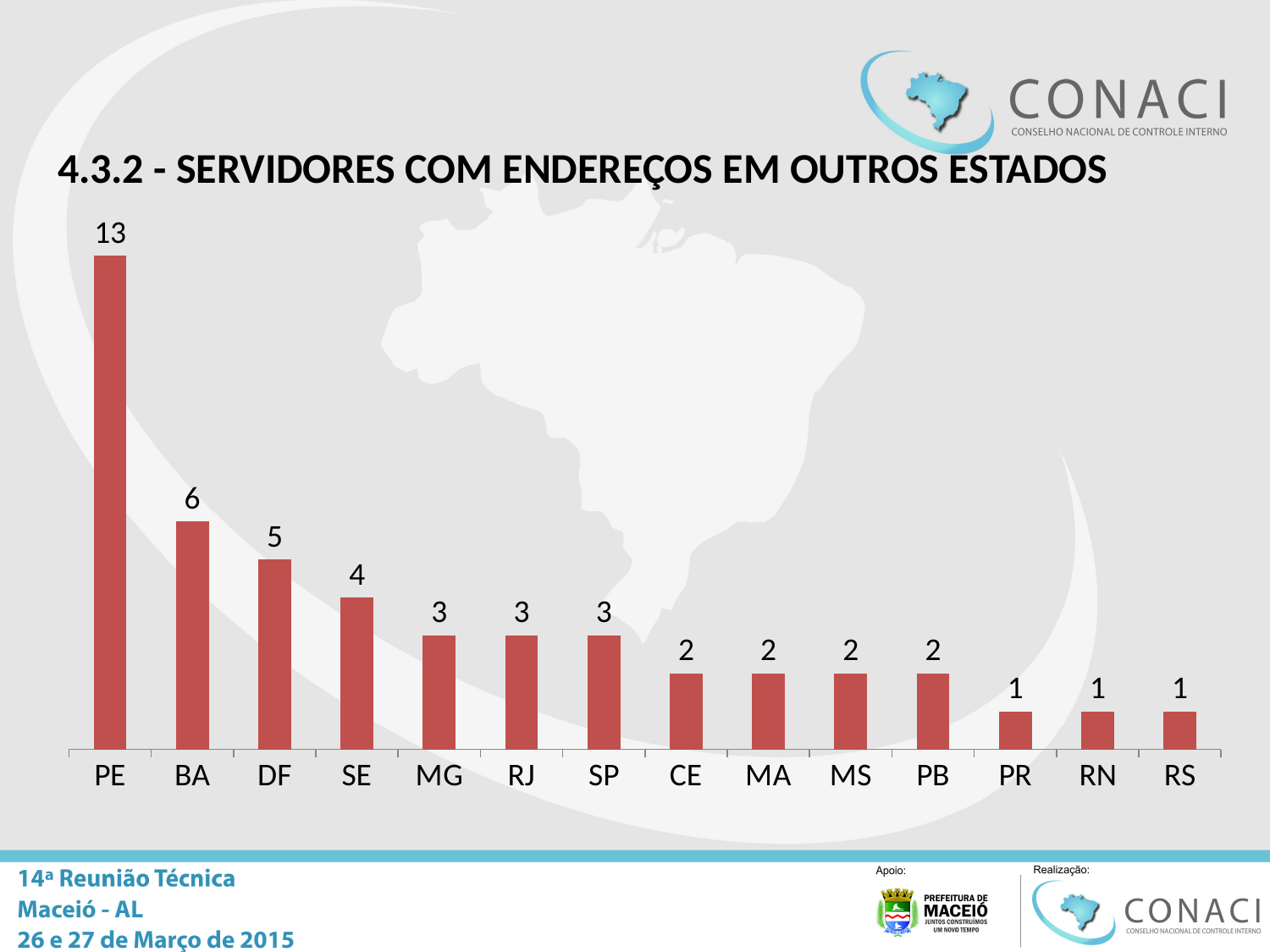
What kind of chart is this? bar chart Which state has the highest value? PE What is the value for SE? 4 Do the values rise or fall from left to right along the x axis? fall What is the difference between the values for PE and BA? 7 What is the difference between the values for DF and MG? 2 Which is larger, the value for DF or the value for SP? DF What is the value for PE? 13 What is the value for PB? 2 What is the title of the slide's chart section? 4.3.2 - SERVIDORES COM ENDEREÇOS EM OUTROS ESTADOS How many states are shown on the x axis? 14 What is the value for BA? 6